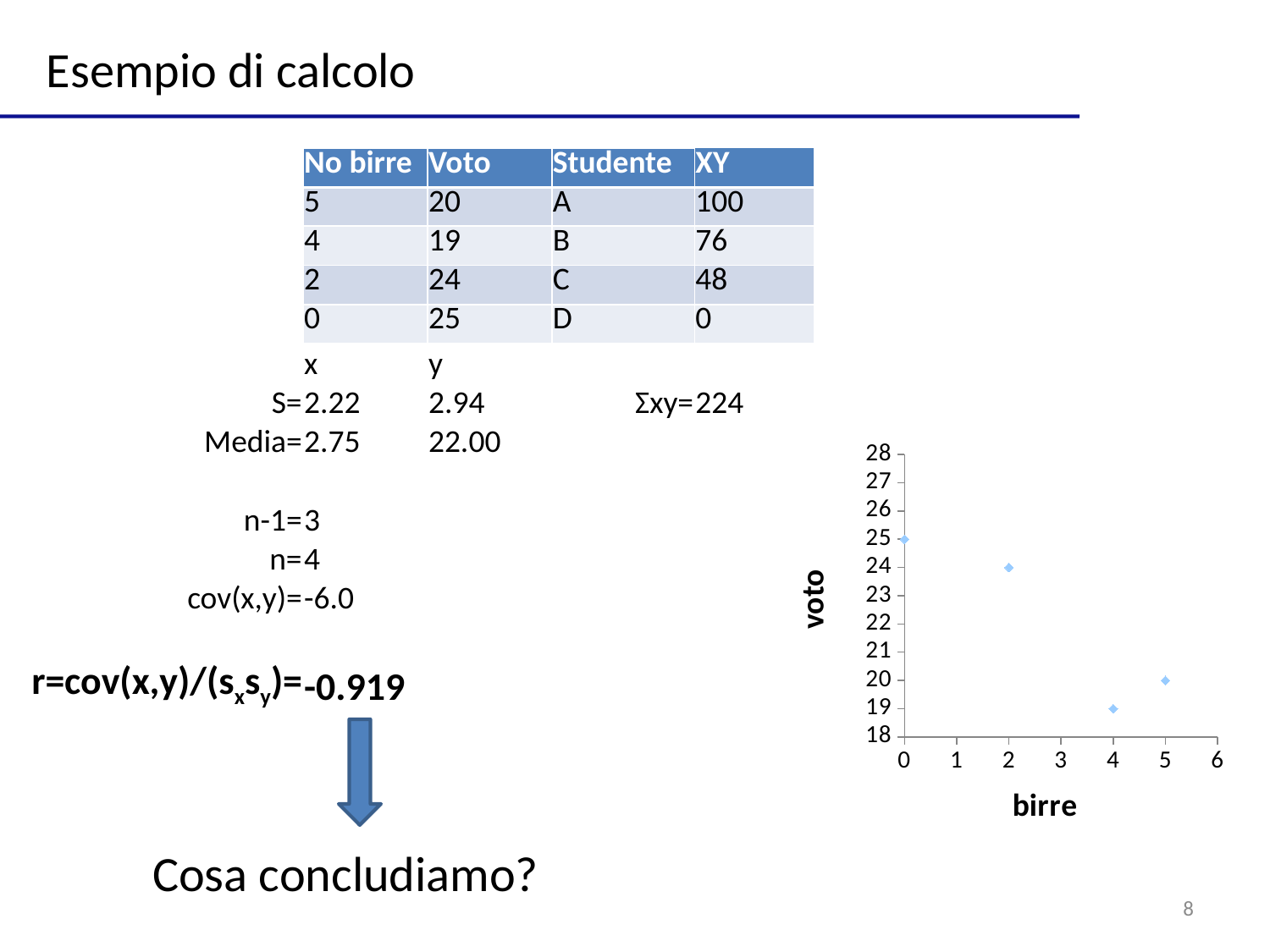
What is the difference in voto between the point at birre = 0 and the point at birre = 4? 6 At which birre value is the voto highest? 0 Overall, does voto rise or fall as birre increases along the x axis? fall At which birre value is the voto lowest? 4 How many data points are plotted in the scatter chart? 4 What is the label of the y axis of the chart? voto What is the voto value of the point at birre = 5? 20 What is the label of the x axis of the chart? birre What is the voto value of the point at birre = 2? 24 What is the voto value of the point at birre = 0? 25 What kind of chart is shown on the slide? scatter chart What is the voto value of the point at birre = 4? 19